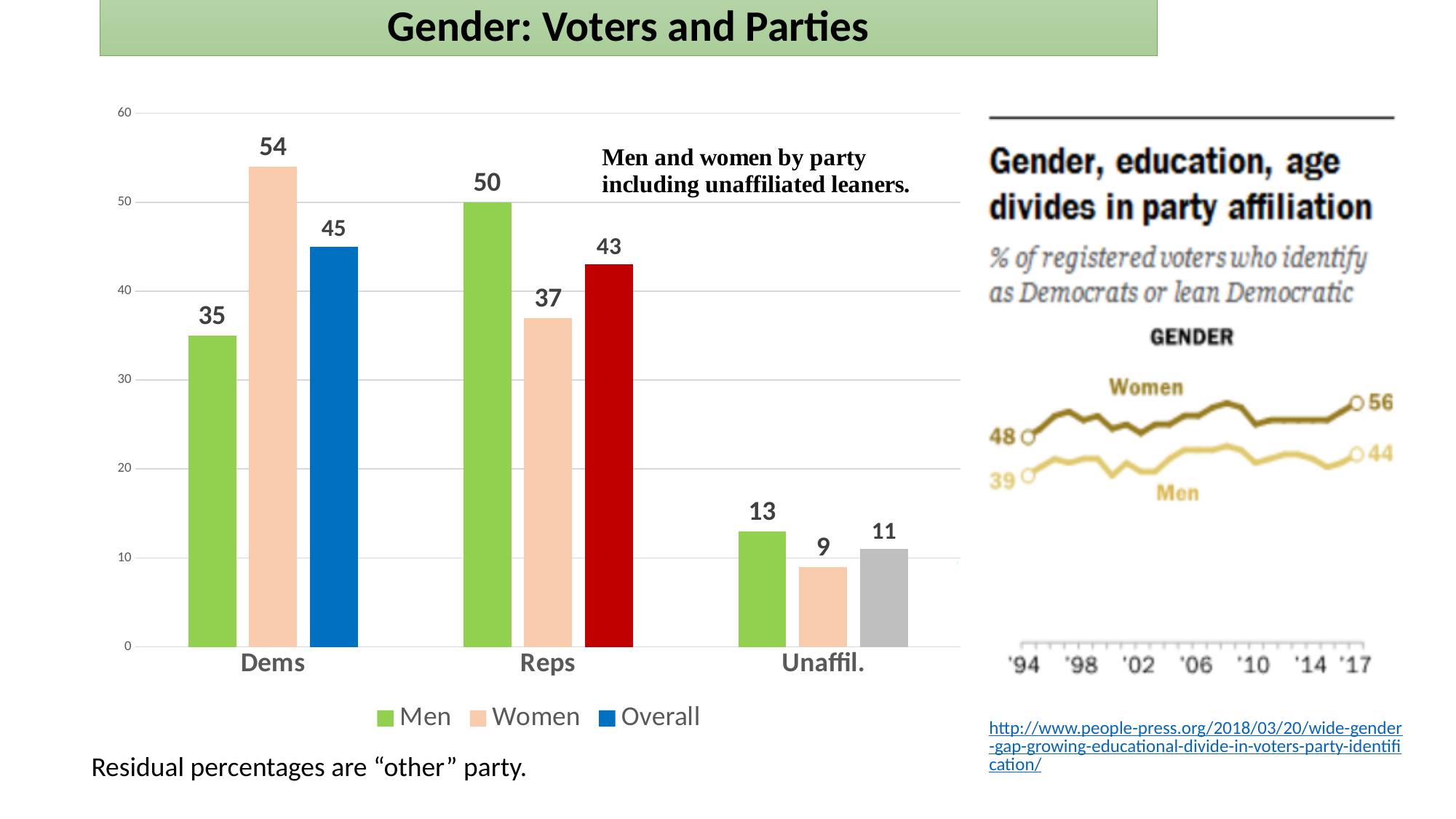
How many categories are shown on the x axis of the bar chart on the left? 3 In the line chart on the right, what is the value for Women at the end of the series in '17? 56 In the bar chart on the left, which category has the lowest value for Women? Unaffil. In the bar chart on the left, what is the value for Women in the Dems category? 54 How many series does the legend of the bar chart on the left list? 3 In the bar chart on the left, what is the difference between the Women and Men values in the Dems category? 19 In the line chart on the right, what is the difference between the Men value in '17 and the Men value in '94? 5 In the bar chart on the left, which is larger: the Overall value for Dems or the Overall value for Reps? Dems In the bar chart on the left, what is the Overall value for Unaffil.? 11 What kind of chart is the chart on the right side of the slide? line chart In the bar chart on the left, which category has the highest value for Men? Reps In the bar chart on the left, what is the value for Men in the Reps category? 50